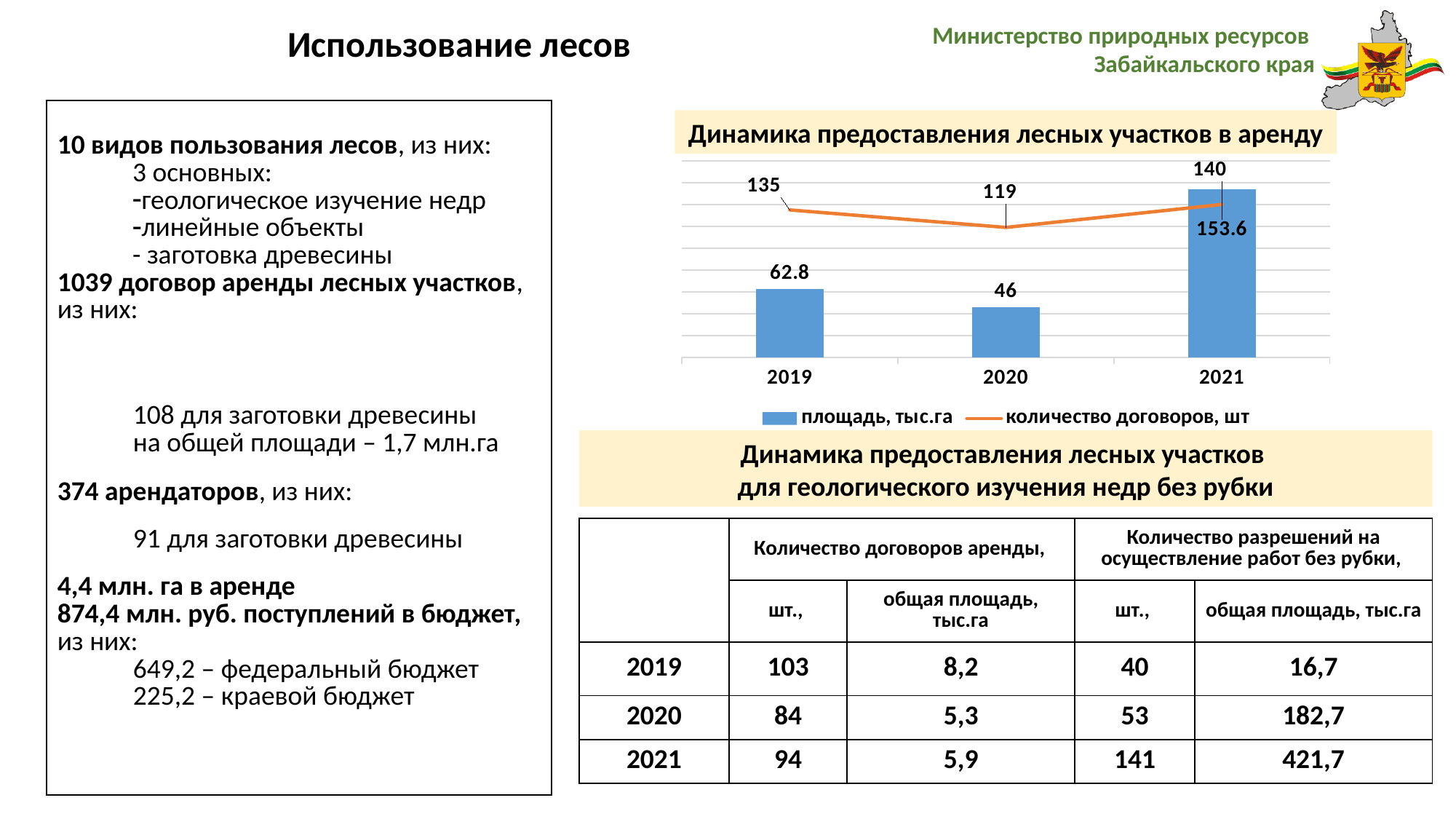
What is the value of количество договоров, шт for 2020? 119 Which year has the highest value of площадь, тыс.га? 2021 What is the value of площадь, тыс.га for 2019? 62.8 What kind of chart is used to show площадь, тыс.га? bar chart What is the value of площадь, тыс.га for 2021? 153.6 How many years are shown on the x axis of the chart? 3 Which year has the lowest value of количество договоров, шт? 2020 What is the difference between площадь, тыс.га in 2021 and 2020? 107.6 What is the difference between количество договоров, шт in 2019 and 2020? 16 How many series does the chart legend list? 2 Which is larger: площадь, тыс.га in 2019 or in 2020? 2019 What is the title of the chart? Динамика предоставления лесных участков в аренду